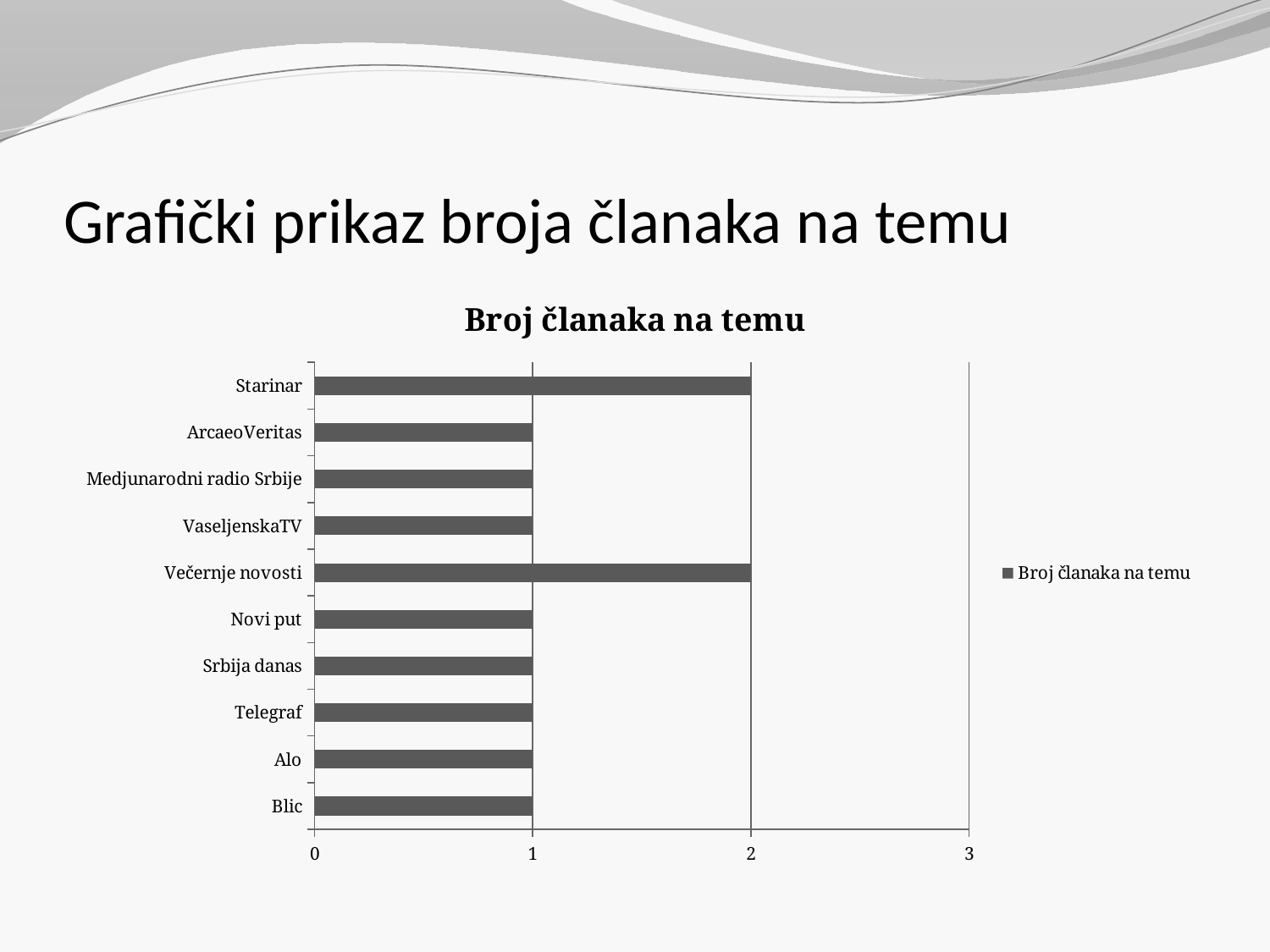
What is the value for Blic? 1 Which is larger, the value for Starinar or the value for Telegraf? Starinar Is the value for Starinar greater or less than 1? greater What type of chart is shown on the slide? bar chart What is the difference between the value for Večernje novosti and the value for Novi put? 1 How many series does the legend list? 1 What is the value for Večernje novosti? 2 What is the value for Starinar? 2 How many categories are shown on the chart? 10 What is the title of the chart? Broj članaka na temu Which two categories have the highest value on the chart? Starinar and Večernje novosti What is the value for Medjunarodni radio Srbije? 1